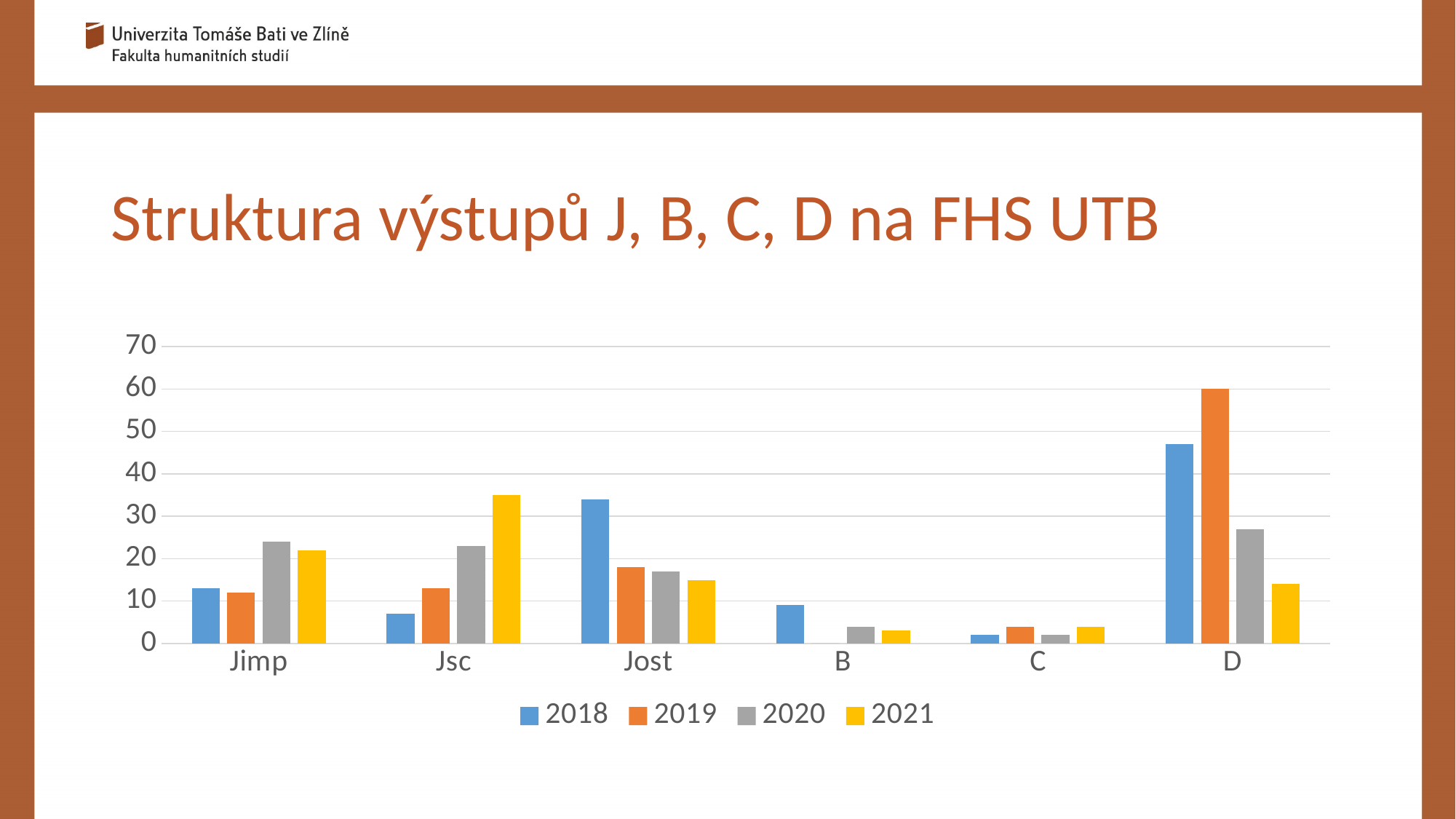
Within category Jsc, which year has the lowest value? 2018 What kind of chart is shown on the slide? bar chart Do the values for Jsc rise or fall from 2018 to 2021? rise Is the value for D in 2018 greater or less than 40? greater Within category Jost, which year has the highest value? 2018 How many series does the legend list? 4 Which category has the tallest bar in the chart? D Within category D, which year has the highest value? 2019 Which is larger: the 2020 value for Jimp or the 2020 value for Jost? Jimp What is the title of the chart slide? Struktura výstupů J, B, C, D na FHS UTB Is the value for Jsc in 2021 greater or less than 30? greater How many categories are shown on the x axis? 6